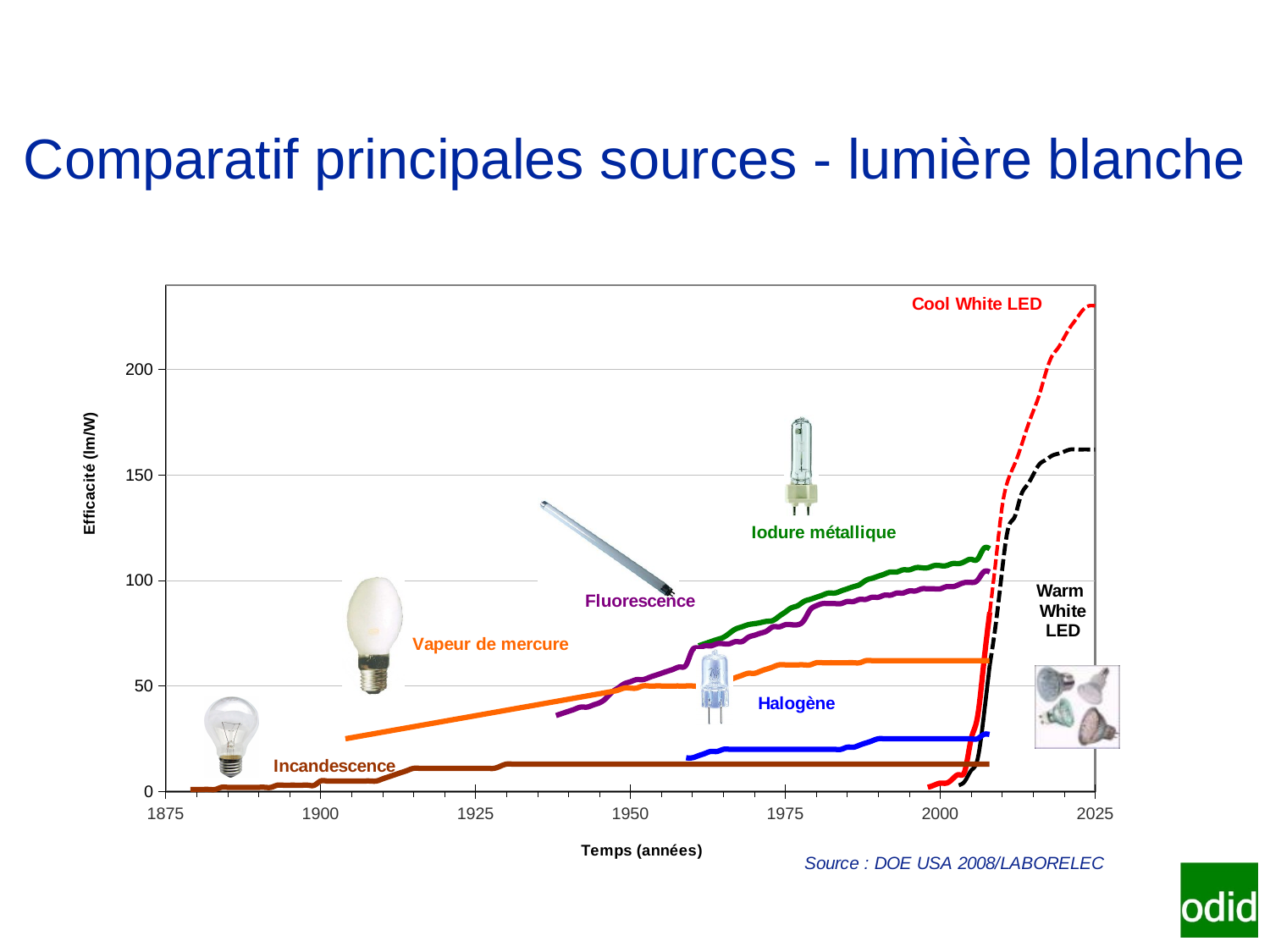
What kind of chart is shown on the slide? Line chart Which light source has the lowest efficacy throughout the chart? Incandescence Does the efficacy of Vapeur de mercure rise or fall over time along the x axis? rise Is the projected efficacy of Cool White LED at 2025 greater or less than 200 lm/W? greater How many light sources are plotted on the chart? 7 Is the efficacy of Incandescence around the year 2000 greater or less than 50 lm/W? less At 2025, which is projected to have higher efficacy: Cool White LED or Warm White LED? Cool White LED Is the projected efficacy of Warm White LED at 2025 greater or less than 200 lm/W? less What is the label of the y axis of the chart? Efficacité (lm/W) Around the year 2000, which has higher efficacy: Iodure métallique or Fluorescence? Iodure métallique Which light source reaches the highest efficacy on the chart? Cool White LED